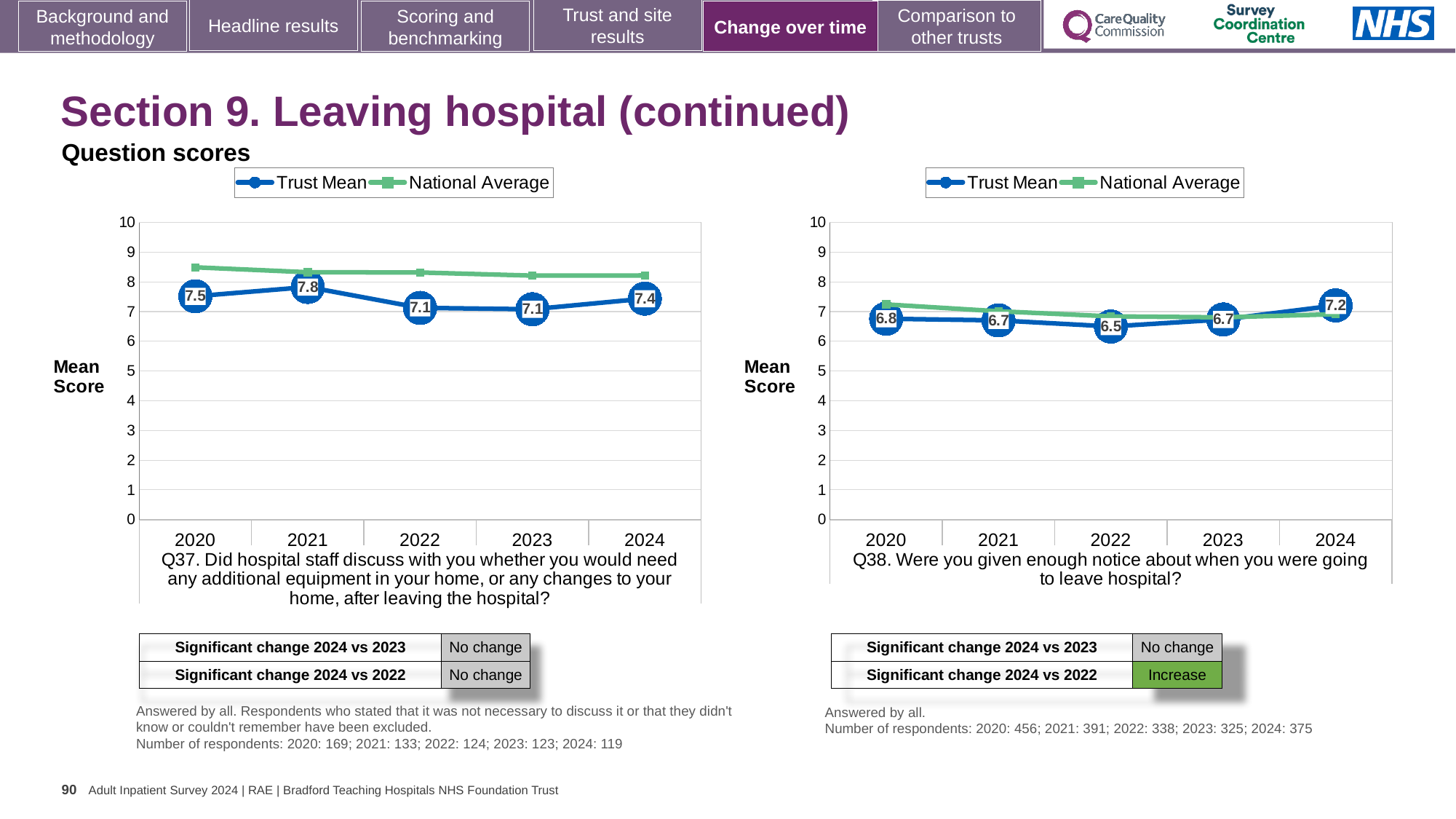
How many years are shown on the x axis of the Q38 chart (right)? 5 In the Q37 chart (left), what is the Trust Mean score for 2021? 7.8 In the Q38 chart (right), is the National Average for 2022 greater or less than 8? less In the Q37 chart (left), is the Trust Mean score for 2020 higher or lower than for 2022? higher In the Q38 chart (right), which year has the lowest Trust Mean score? 2022 In the Q38 chart (right), what is the Trust Mean score for 2024? 7.2 In the Q37 chart (left), which year has the highest Trust Mean score? 2021 In the Q38 chart (right), does the Trust Mean score rise or fall from 2023 to 2024? rise In the Q38 chart (right), what is the difference between the Trust Mean scores for 2024 and 2022? 0.7 In the Q37 chart (left), is the National Average for 2020 greater or less than 8? greater What type of chart is used for the Q38 chart (right)? line chart How many series does the legend of the Q37 chart (left) list? 2